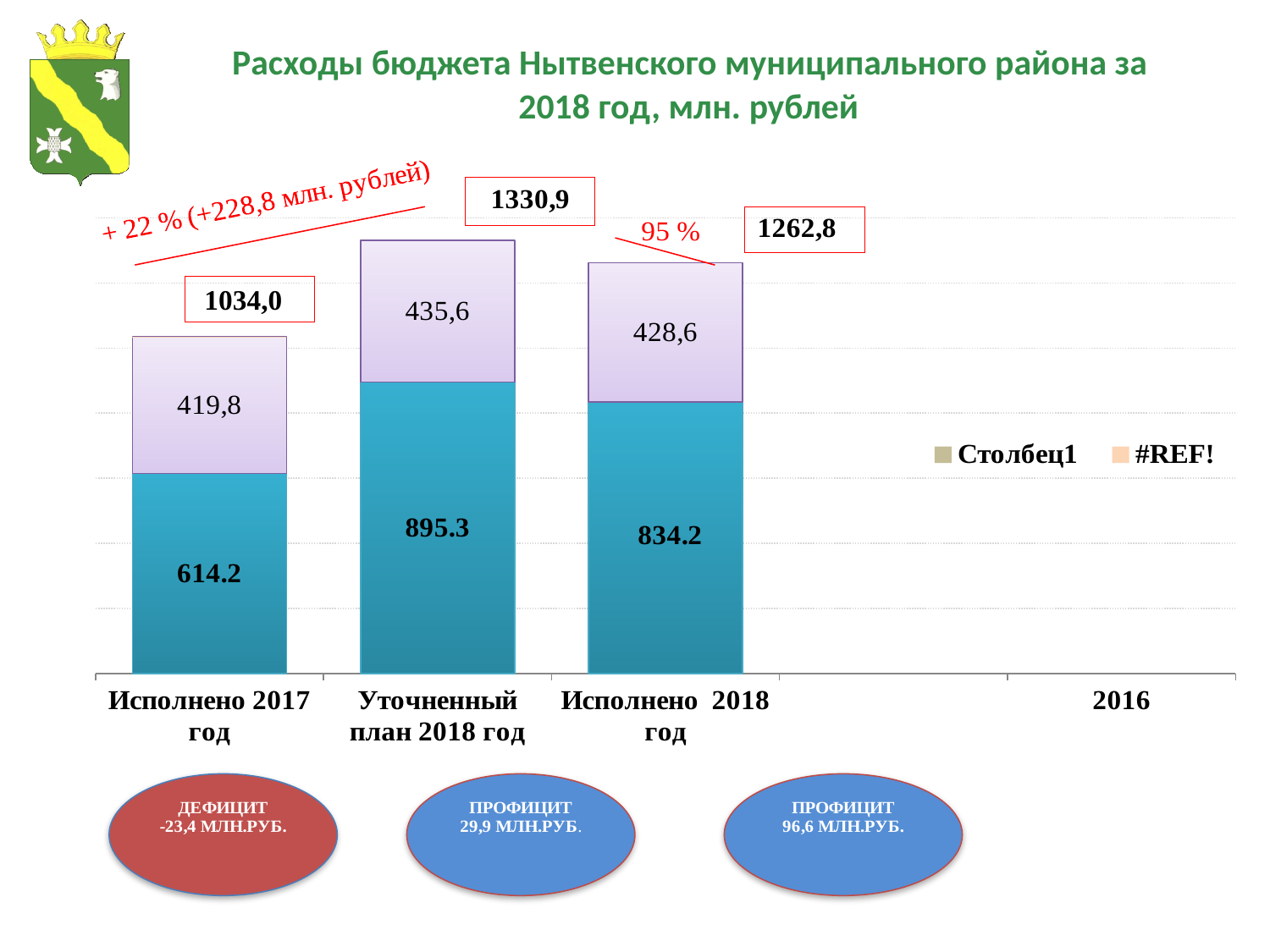
What is the difference between the total for Уточненный план 2018 год (1330,9) and the total for Исполнено 2018 год (1262,8)? 68,1 What is the title of the slide's chart? Расходы бюджета Нытвенского муниципального района за 2018 год, млн. рублей What kind of chart is shown on the slide? Stacked bar chart What is the value of the lower (teal) segment of the bar for Исполнено 2018 год? 834.2 Which is larger: the upper (lilac) segment for Исполнено 2017 год or the upper (lilac) segment for Исполнено 2018 год? Исполнено 2018 год What is the total shown above the bar for Исполнено 2018 год? 1262,8 How many bars are plotted on the chart? 3 What is the value of the lower (teal) segment of the bar for Исполнено 2017 год? 614.2 Which category has the highest total bar value? Уточненный план 2018 год How many entries does the legend list? 2 Which category has the lowest total bar value? Исполнено 2017 год What is the value of the upper (lilac) segment of the bar for Уточненный план 2018 год? 435,6